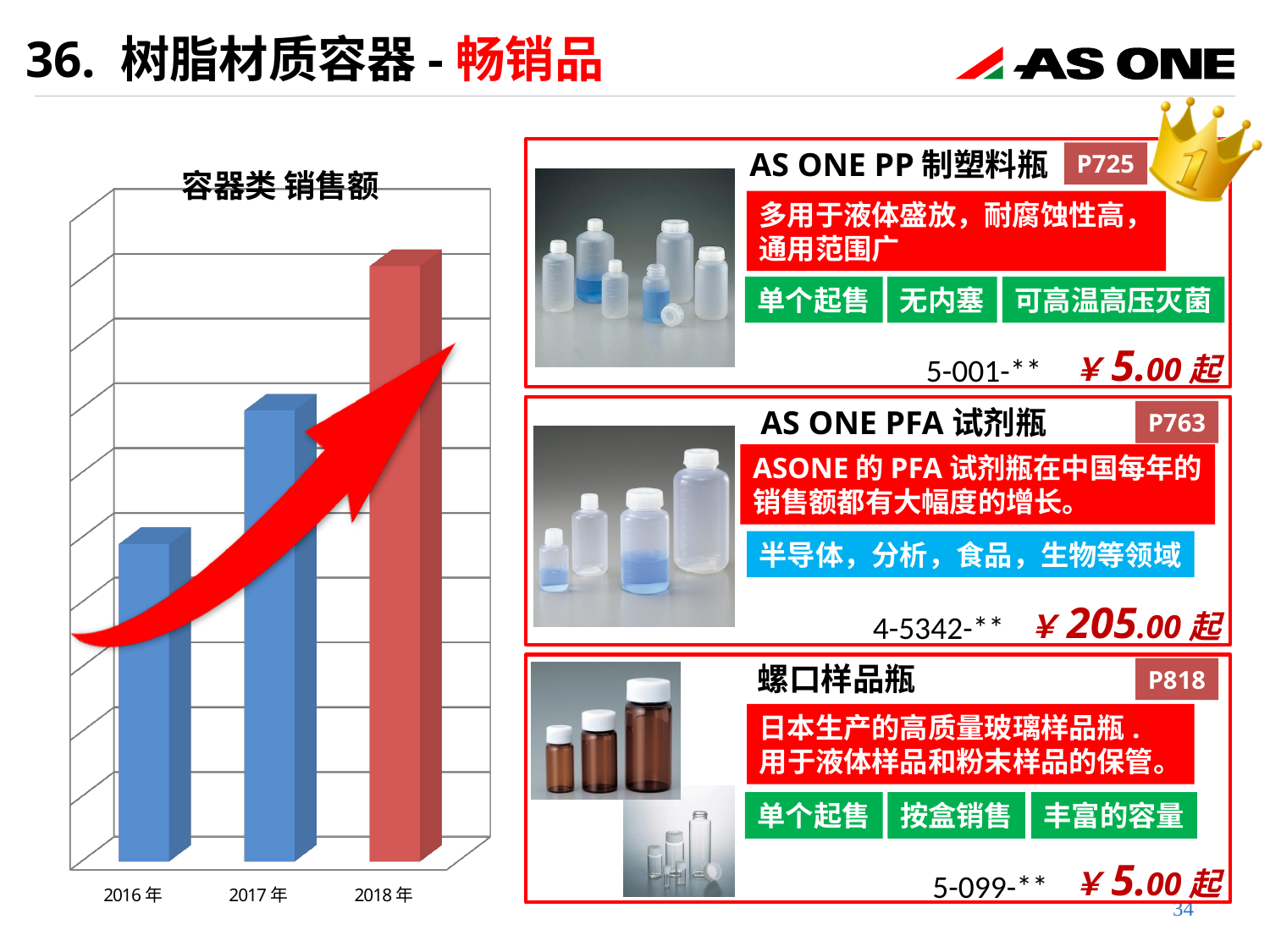
Which is larger in the chart, the value for 2017年 or the value for 2016年? 2017年 Which year has the highest bar in the chart? 2018年 How many categories are shown on the x axis of the chart? 3 What is the first category on the x axis of the chart? 2016年 What is the title of the chart on the slide? 容器类 销售额 Do the values in the chart rise or fall from 2016年 to 2018年? rise What colour is the bar for 2018年 in the chart? red Which year has the lowest bar in the chart? 2016年 Which is larger in the chart, the value for 2018年 or the value for 2017年? 2018年 What kind of chart is shown on the slide? bar chart